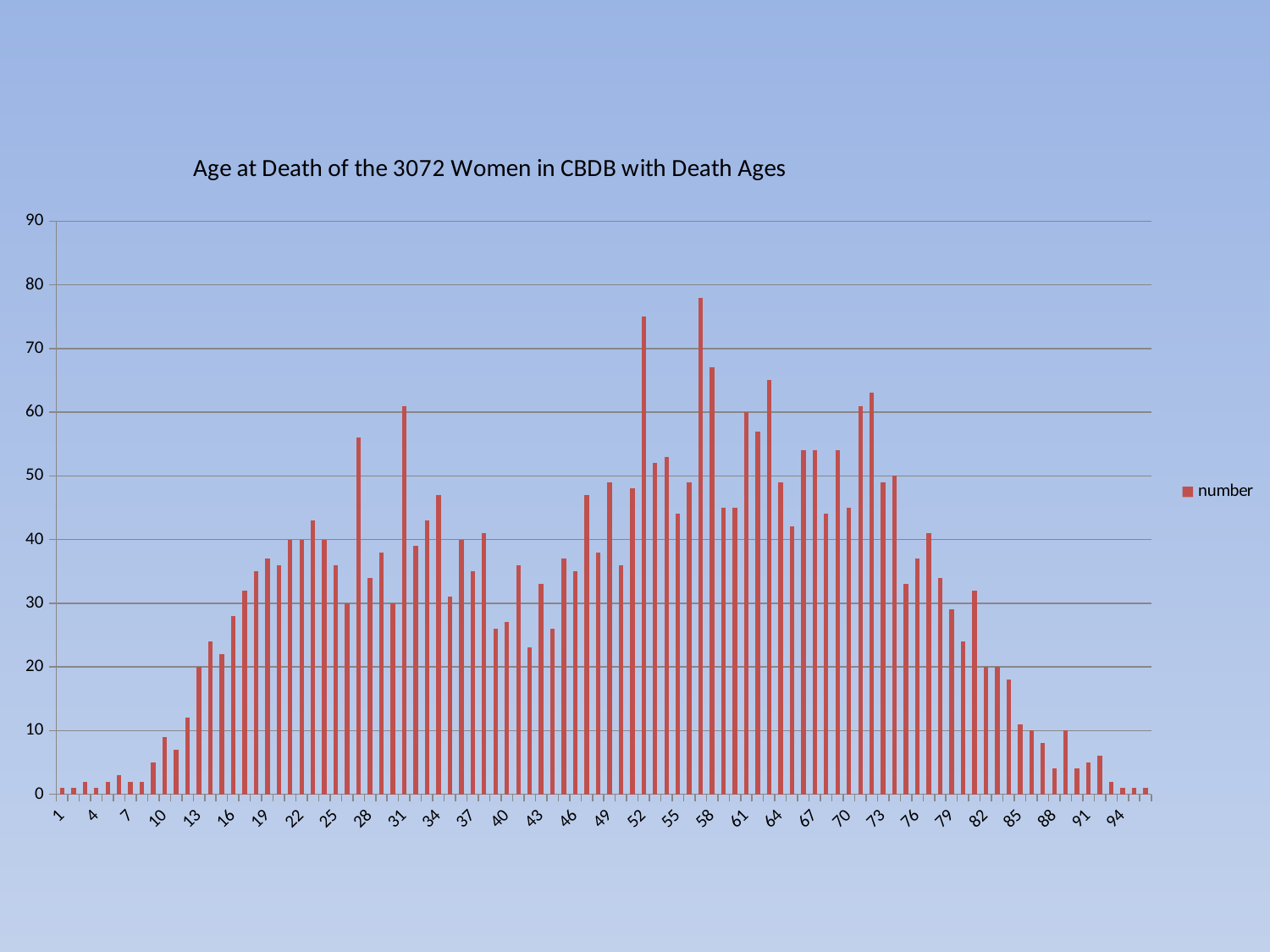
What is the name of the series shown in the legend? number How many series does the legend list? 1 Is the value for age 7 greater or less than 10? less Do the values generally rise or fall along the x axis from age 73 to age 94? fall Is the value for age 40 greater or less than 30? less Is the value for age 94 greater or less than 10? less What kind of chart is shown on the slide? bar chart What is the title of the chart? Age at Death of the 3072 Women in CBDB with Death Ages